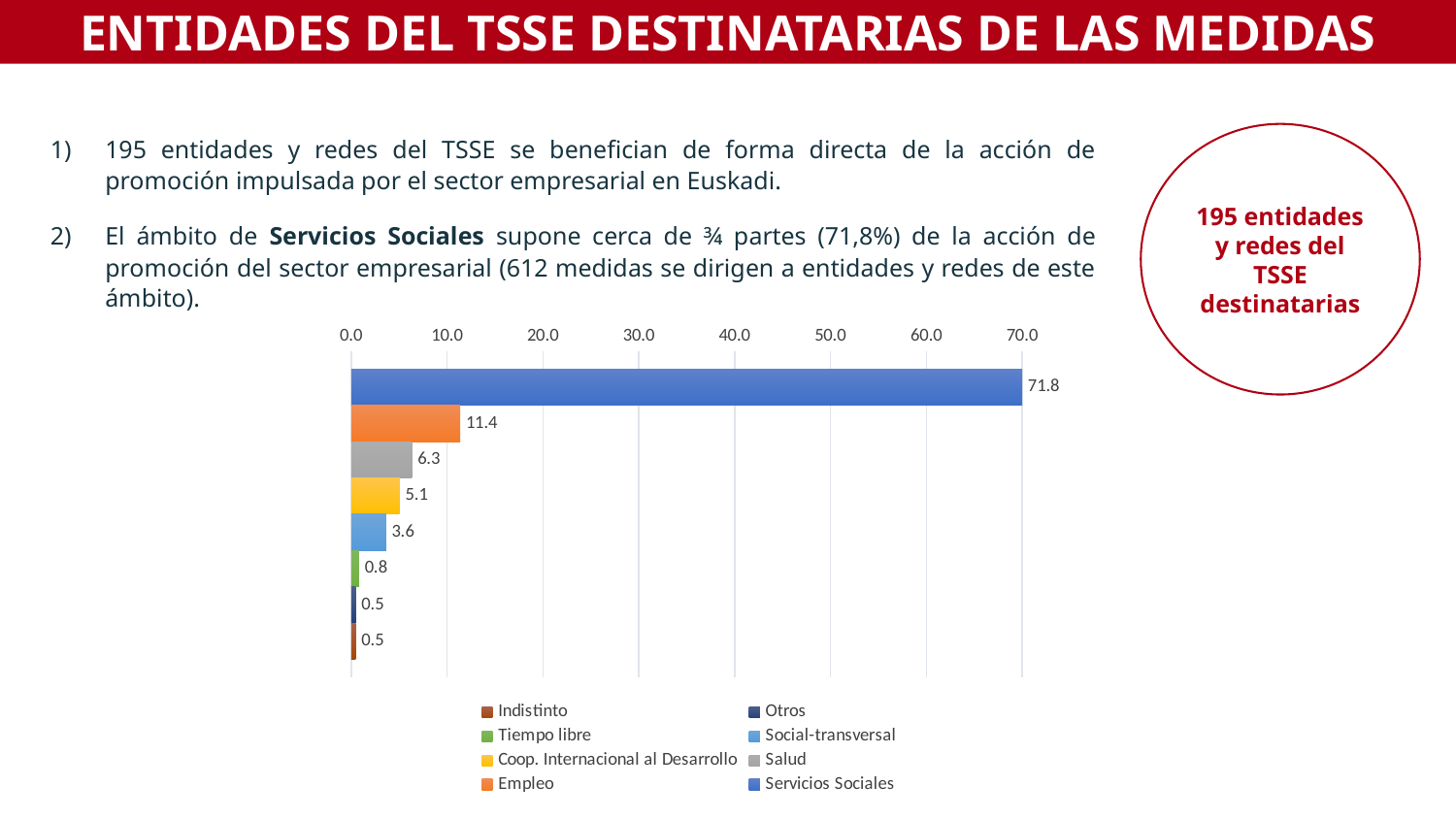
What is the value for Salud? 6.3 Which category has the highest value? Servicios Sociales Is the value for Servicios Sociales greater or less than 70.0? greater What is the value for Social-transversal? 3.6 What is the value for Servicios Sociales? 71.8 How many series does the legend list? 8 What kind of chart is shown on the slide? bar chart What is the value for Empleo? 11.4 Which is larger, the value for Salud or the value for Coop. Internacional al Desarrollo? Salud What is the difference between the values for Servicios Sociales and Empleo? 60.4 What is the value for Tiempo libre? 0.8 What is the value for Coop. Internacional al Desarrollo? 5.1